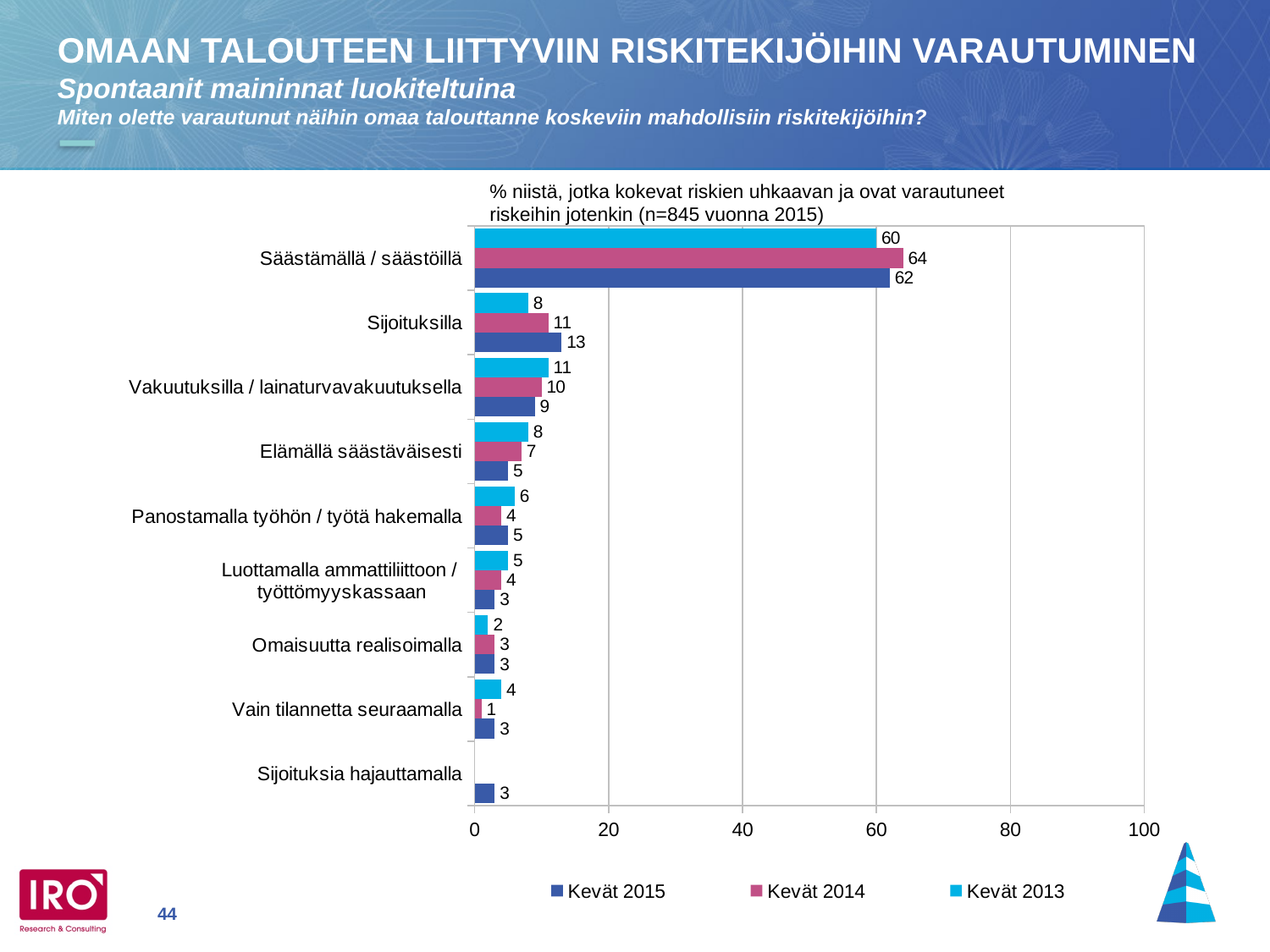
What kind of chart is shown on the slide? bar chart Is the Kevät 2015 value for Säästämällä / säästöillä greater or less than 40? greater What is the value for Sijoituksilla in Kevät 2015? 13 What is the value for Vain tilannetta seuraamalla in Kevät 2014? 1 What is the value for Säästämällä / säästöillä in Kevät 2014? 64 Which category has the highest value in Kevät 2015? Säästämällä / säästöillä What is the value for Vakuutuksilla / lainaturvavakuutuksella in Kevät 2013? 11 How many series does the legend list? 3 What is the difference between the Kevät 2014 and Kevät 2013 values for Säästämällä / säästöillä? 4 Which series is shown in the dark blue bars? Kevät 2015 How many categories are shown on the chart? 9 Which is larger for Elämällä säästäväisesti: the Kevät 2013 value or the Kevät 2015 value? Kevät 2013